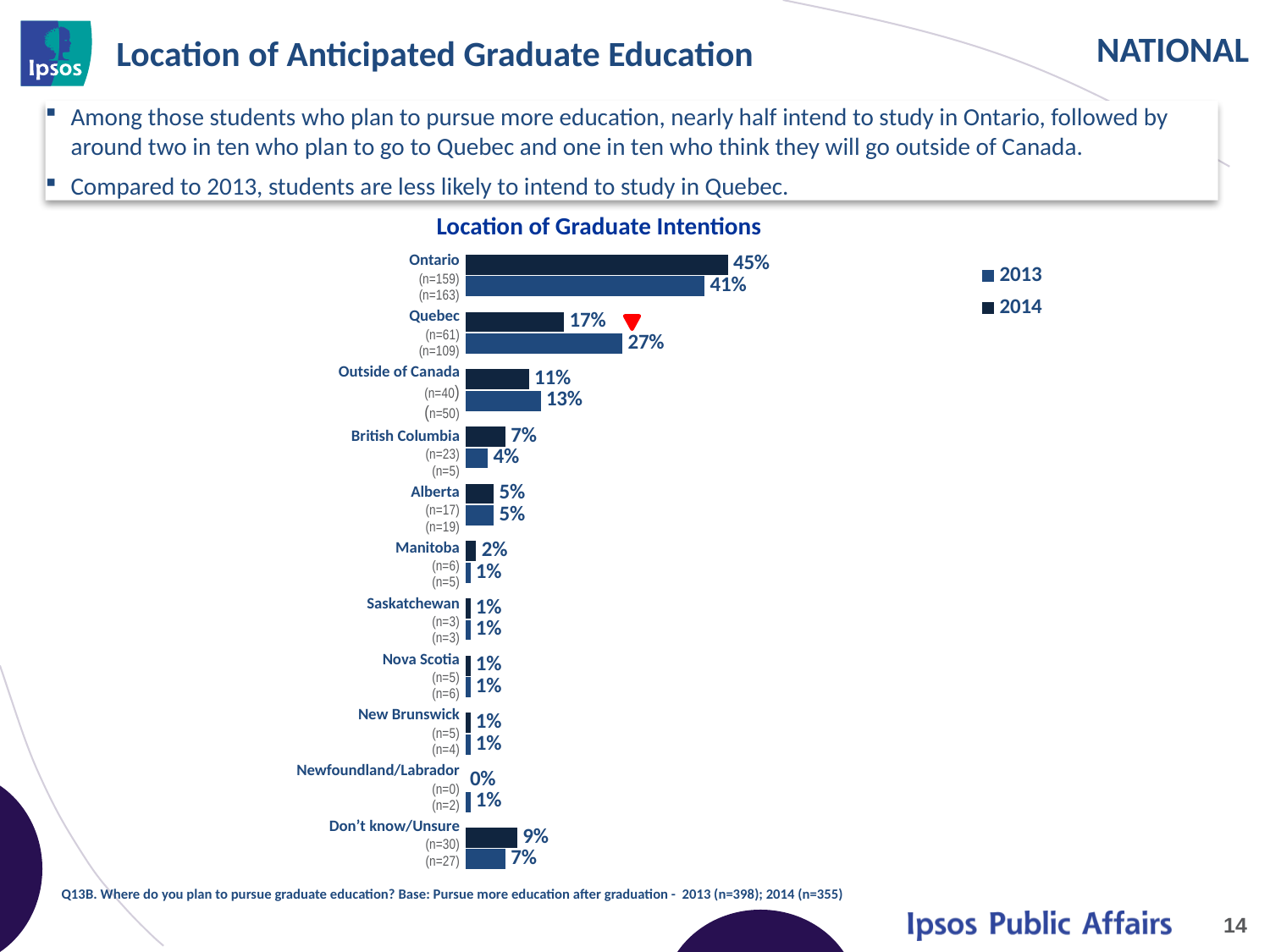
What are the two values shown for Don't know/Unsure? 9% and 7% Which category has larger values, Outside of Canada or Alberta? Outside of Canada What is the difference between the two values shown for Ontario? 4 percentage points How many series does the legend of the chart list? 2 What are the two values shown for Quebec? 17% and 27% What is the title of the chart? Location of Graduate Intentions What are the two values shown for Ontario? 45% and 41% How many categories are shown on the chart? 11 What is the difference between the two values shown for Quebec? 10 percentage points Next to which category's bars is a red downward triangle marker shown? Quebec Which category has the highest values on the chart? Ontario What type of chart is shown on the slide? Bar chart